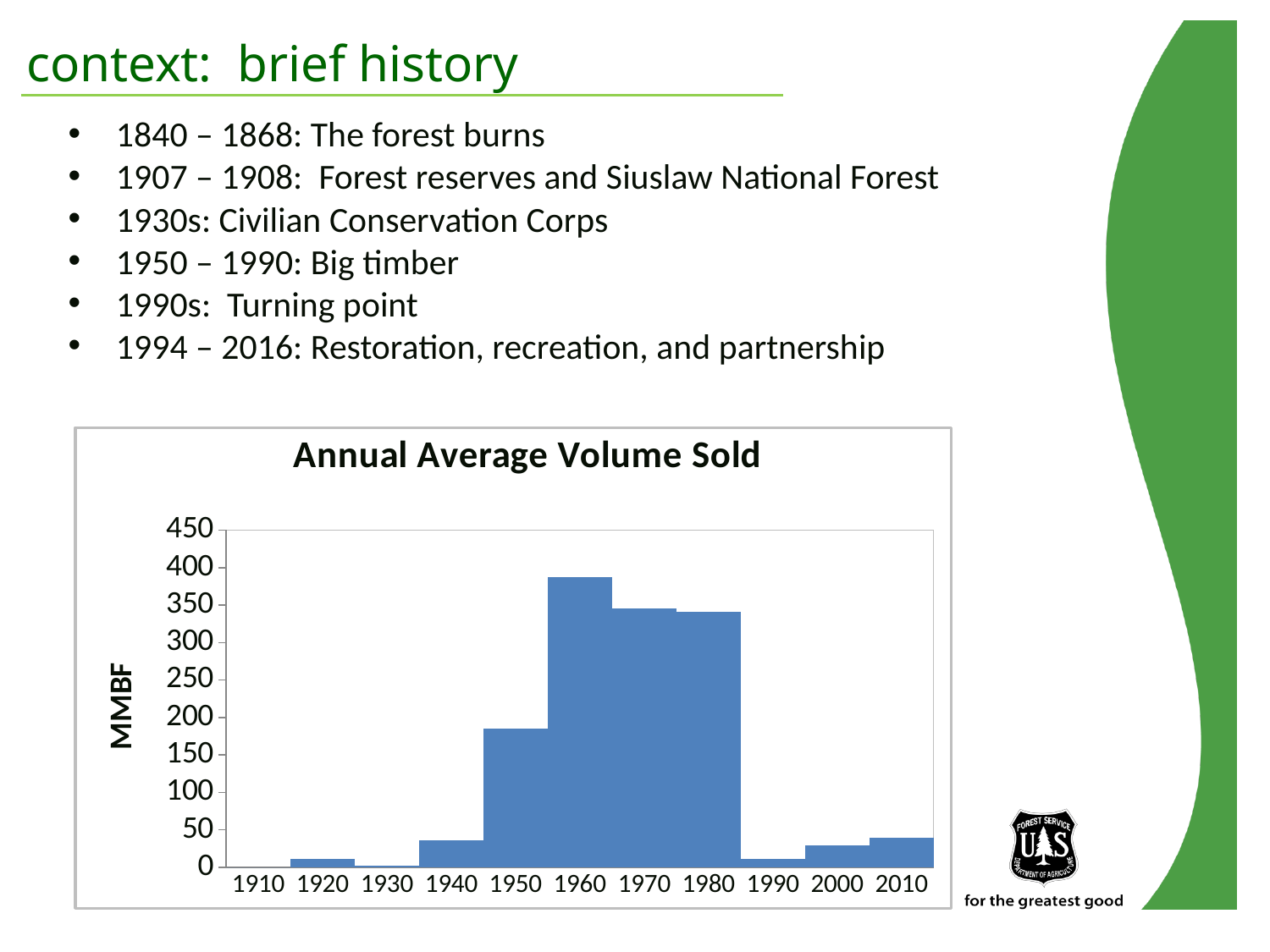
Which is larger, the value for 1960 or the value for 1950? 1960 Do the values rise or fall from 1960 to 1990? fall Is the value for 1960 greater or less than 350? greater Is the value for 1950 greater or less than 200? less Which is larger, the value for 1950 or the value for 2000? 1950 Which decade has the highest annual average volume sold? 1960 Is the value for 1970 greater or less than 300? greater How many decades are shown along the x axis of the chart? 11 What is the label on the vertical axis of the chart? MMBF What type of chart is shown on the slide? bar chart What is the title of the chart? Annual Average Volume Sold